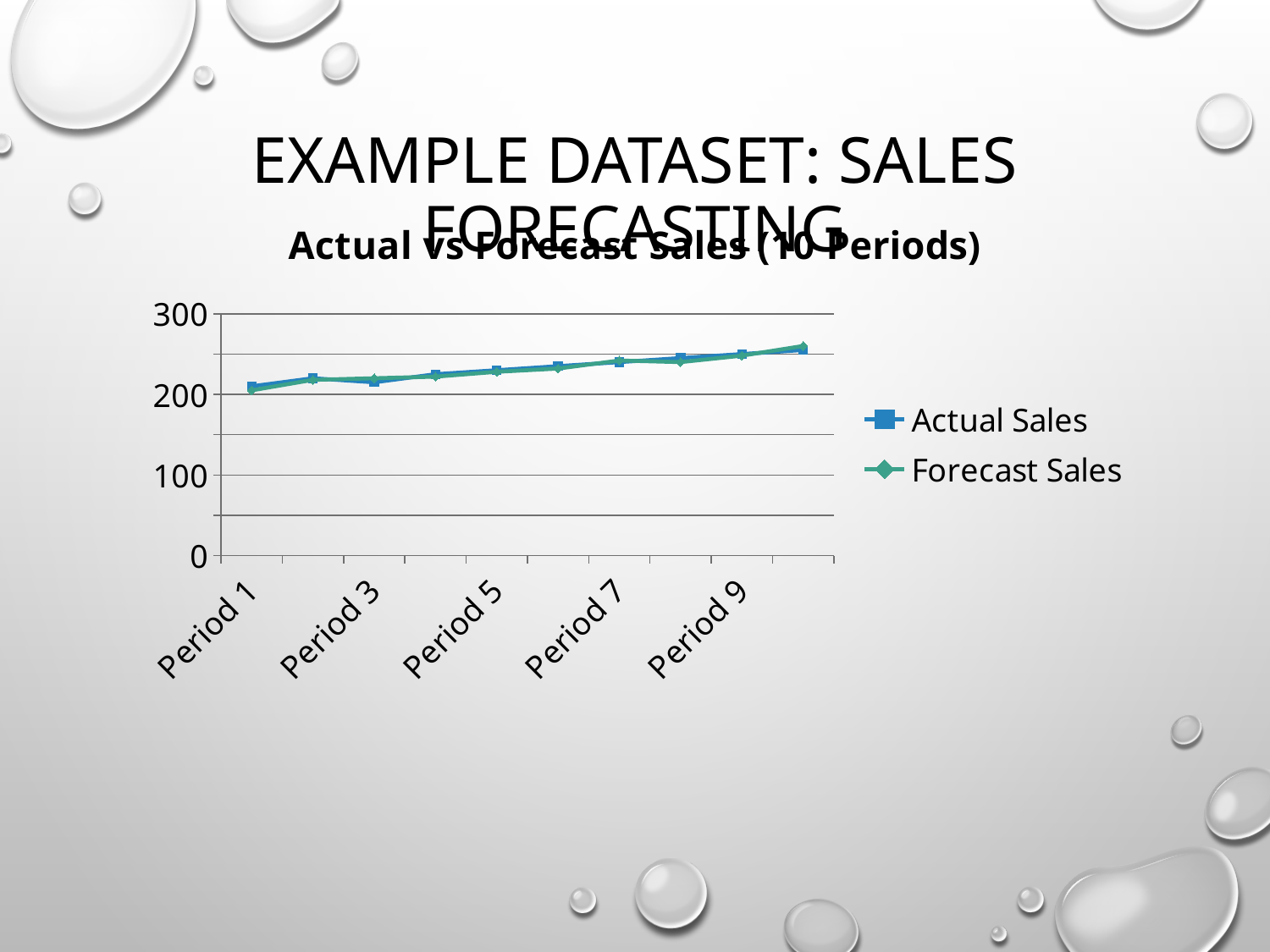
Which period has the highest Actual Sales value? Period 10 Is the Forecast Sales value for Period 10 greater or less than 300? less Is the Actual Sales value for Period 1 greater or less than 200? greater What is the title of the chart? Actual vs Forecast Sales (10 Periods) Which is larger for Actual Sales: the value at Period 1 or the value at Period 10? Period 10 Is the Actual Sales value for Period 5 greater or less than 100? greater How many periods are plotted along the x axis? 10 How many series does the legend list? 2 What are the two series named in the legend? Actual Sales and Forecast Sales Which period has the lowest Forecast Sales value? Period 1 What kind of chart is shown on the slide? Line chart Do the Actual Sales values generally rise or fall from Period 1 to Period 10? Rise